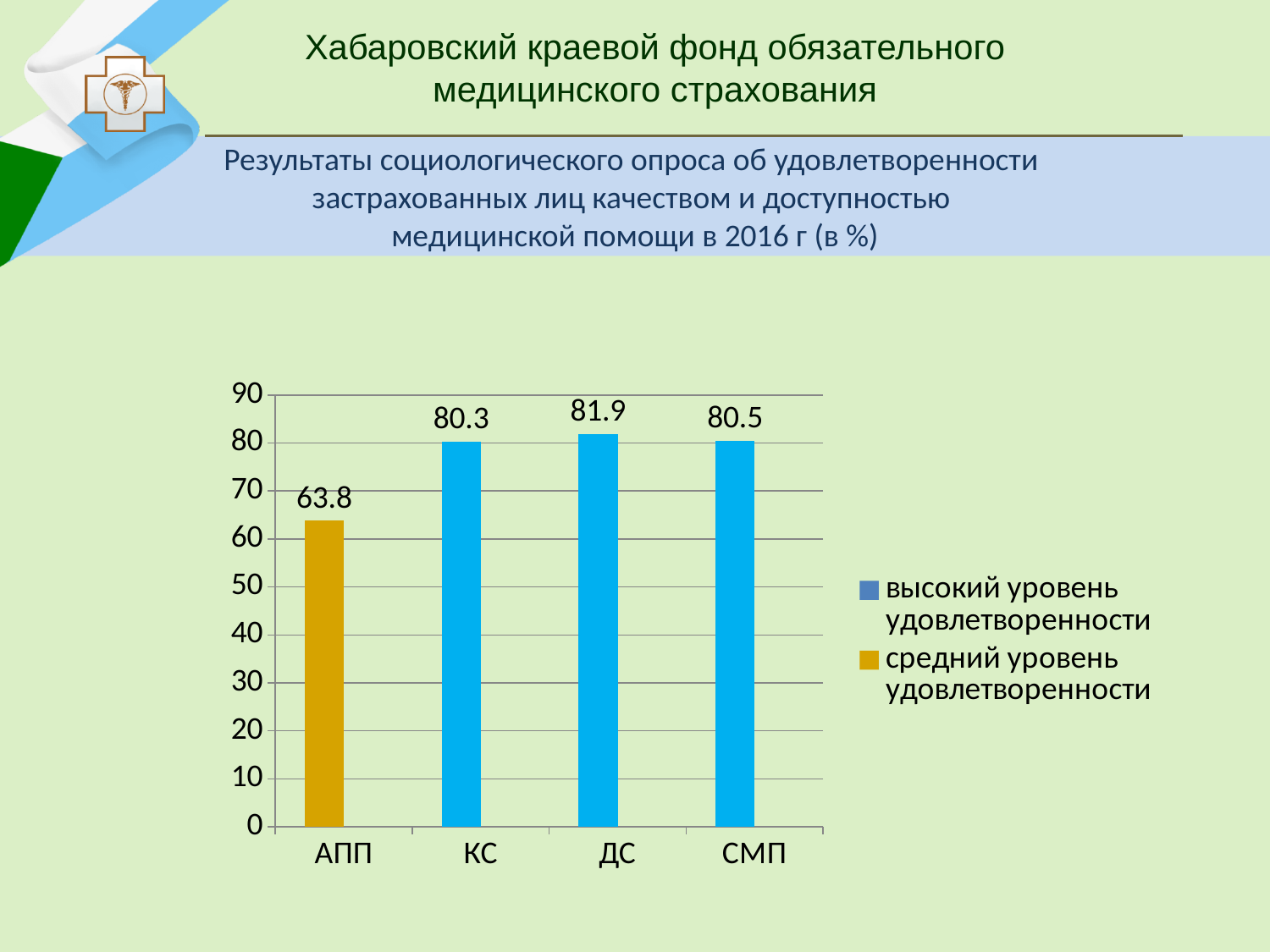
How many categories are shown on the x axis? 4 What is the difference between the values for ДС and АПП? 18.1 Which category has the highest value? ДС What is the value for ДС? 81.9 Which is larger, the value for КС or the value for АПП? КС What is the difference between the values for КС and СМП? 0.2 Which category has the lowest value? АПП What is the value for СМП? 80.5 What is the value for АПП? 63.8 Is the value for АПП greater or less than 70? less What kind of chart is shown on the slide? bar chart How many series does the legend list? 2